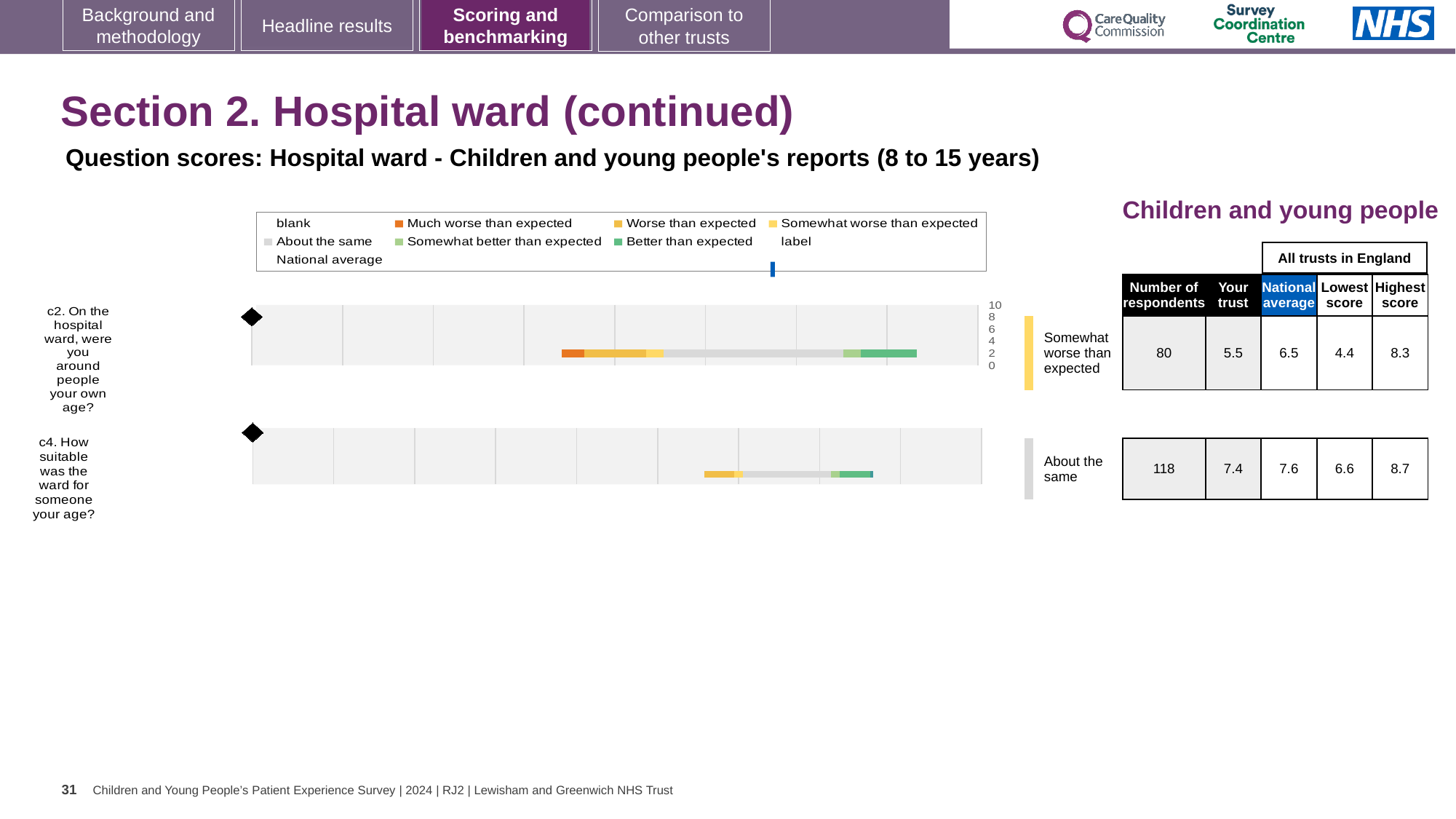
Which question has the higher 'Your trust' score, c2 or c4? c4 What is the difference between the highest score and the lowest score across all trusts in England for question c2? 3.9 What is the highest score across all trusts in England for question c4? 8.7 Which benchmark category is question c2 placed in? Somewhat worse than expected What is the 'Your trust' score for question c2 (On the hospital ward, were you around people your own age?)? 5.5 Which question has the larger number of respondents, c2 or c4? c4 What kind of chart is used to show the question scores on this slide? Bar chart How many respondents answered question c2? 80 How many questions are plotted in the chart on this slide? 2 What is the national average score for question c4 (How suitable was the ward for someone your age?)? 7.6 What is the difference between the national average and the 'Your trust' score for question c2? 1.0 Which benchmark category is question c4 placed in? About the same